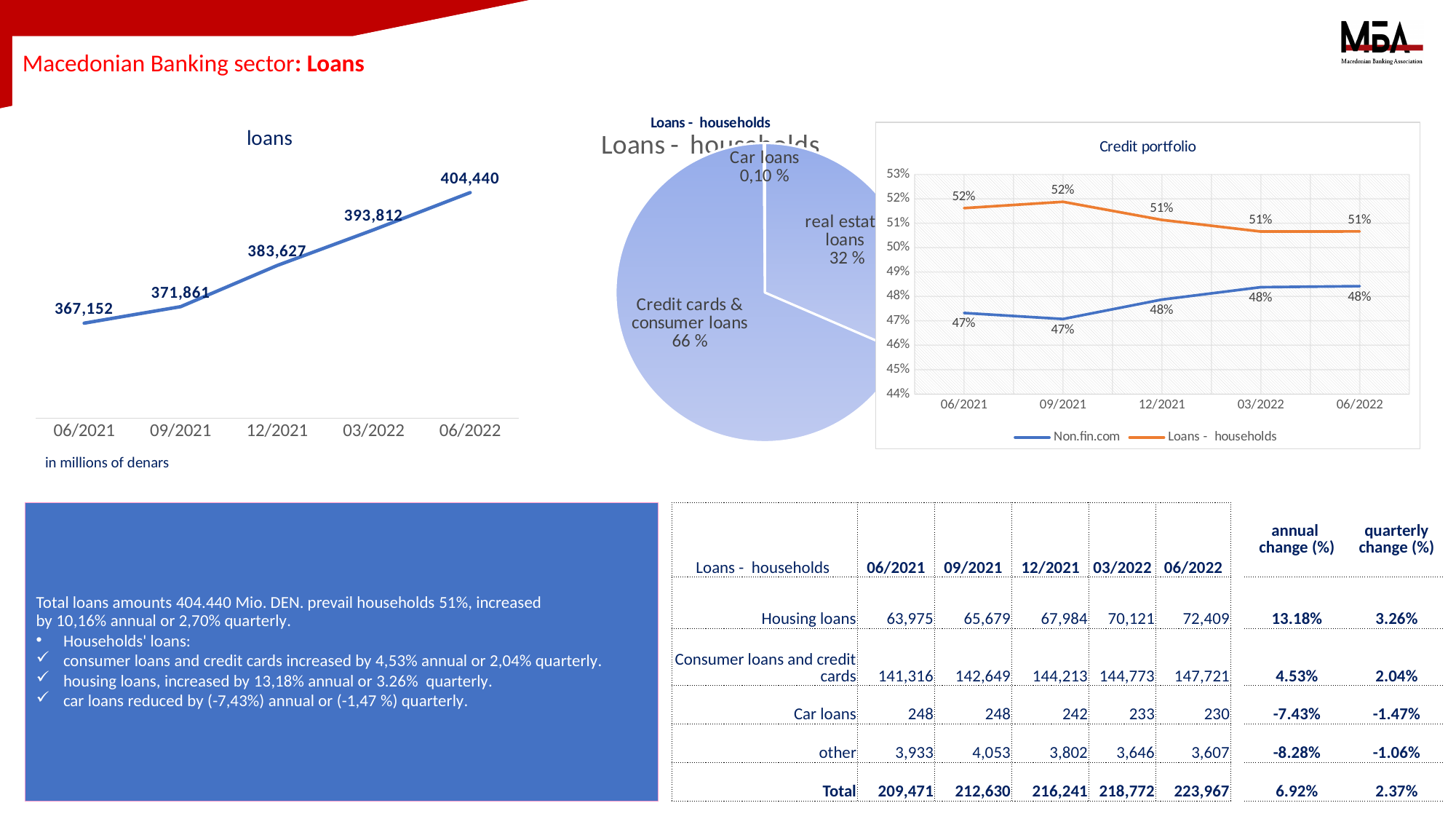
What type of chart is the "loans" chart? line chart In the "loans" chart, what is the value for 12/2021? 383,627 In the "Credit portfolio" chart, what is the value for Loans - households at 09/2021? 52% In the "Loans - households" pie chart, what share do Credit cards & consumer loans have? 66 % How many periods are plotted in the "loans" chart? 5 In the "loans" chart, do the values rise or fall from 06/2021 to 06/2022? rise How many series does the legend of the "Credit portfolio" chart list? 2 In the "loans" chart, which period has the lowest value? 06/2021 In the "Loans - households" pie chart, which slice is the smallest? Car loans In the "loans" chart, what is the value for 06/2022? 404,440 In the "Credit portfolio" chart, which series is higher at 06/2022, Non.fin.com or Loans - households? Loans - households In the "loans" chart, what is the difference between the values for 06/2022 and 06/2021? 37,288